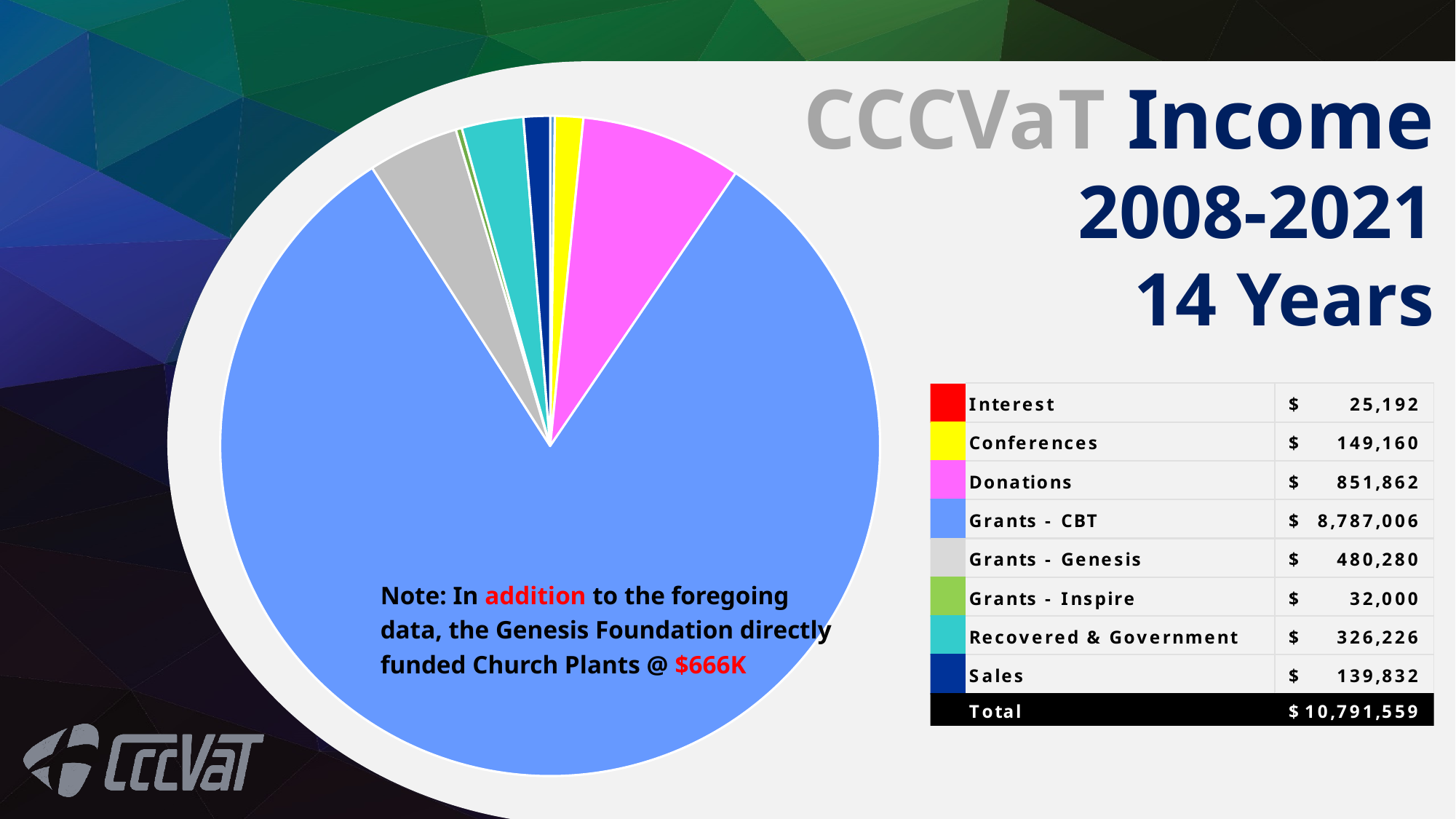
Which income category is the largest? Grants - CBT Which is larger, Grants - Genesis or Recovered & Government? Grants - Genesis Which income category is the smallest? Interest What type of chart is shown on the slide? Pie chart How many income categories does the pie chart show? 8 What is the value for Donations? $851,862 What is the total income shown in the table? $10,791,559 What is the difference between Donations and Grants - Genesis? $371,582 What share of the total income does Grants - CBT represent? 81.4% What is the value for Grants - CBT? $8,787,006 What is the value for Recovered & Government? $326,226 What colour is the Donations slice in the pie chart? Pink